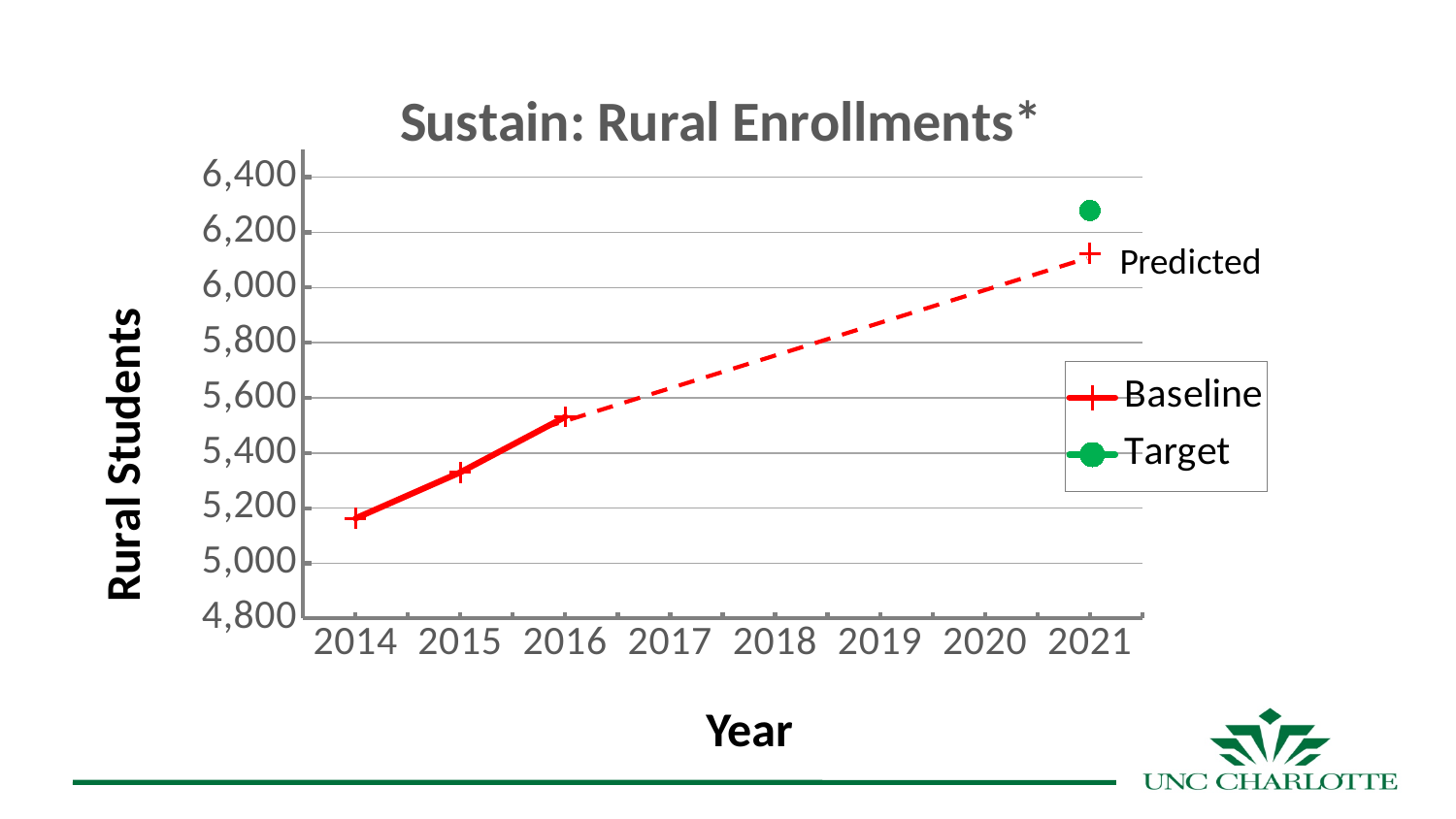
Which year has the lowest Baseline value? 2014 What kind of chart is shown on the slide? line chart Is the Baseline value for 2014 greater or less than 5,200? less Is the predicted Baseline value for 2021 greater or less than 6,000? greater How many years are labelled on the x axis? 8 In 2021, which is higher: the Target or the predicted Baseline? Target What is the title of the chart? Sustain: Rural Enrollments* Do the Baseline values rise or fall from 2014 to 2021? rise Is the Baseline value for 2015 greater or less than 5,200? greater How many series does the legend list? 2